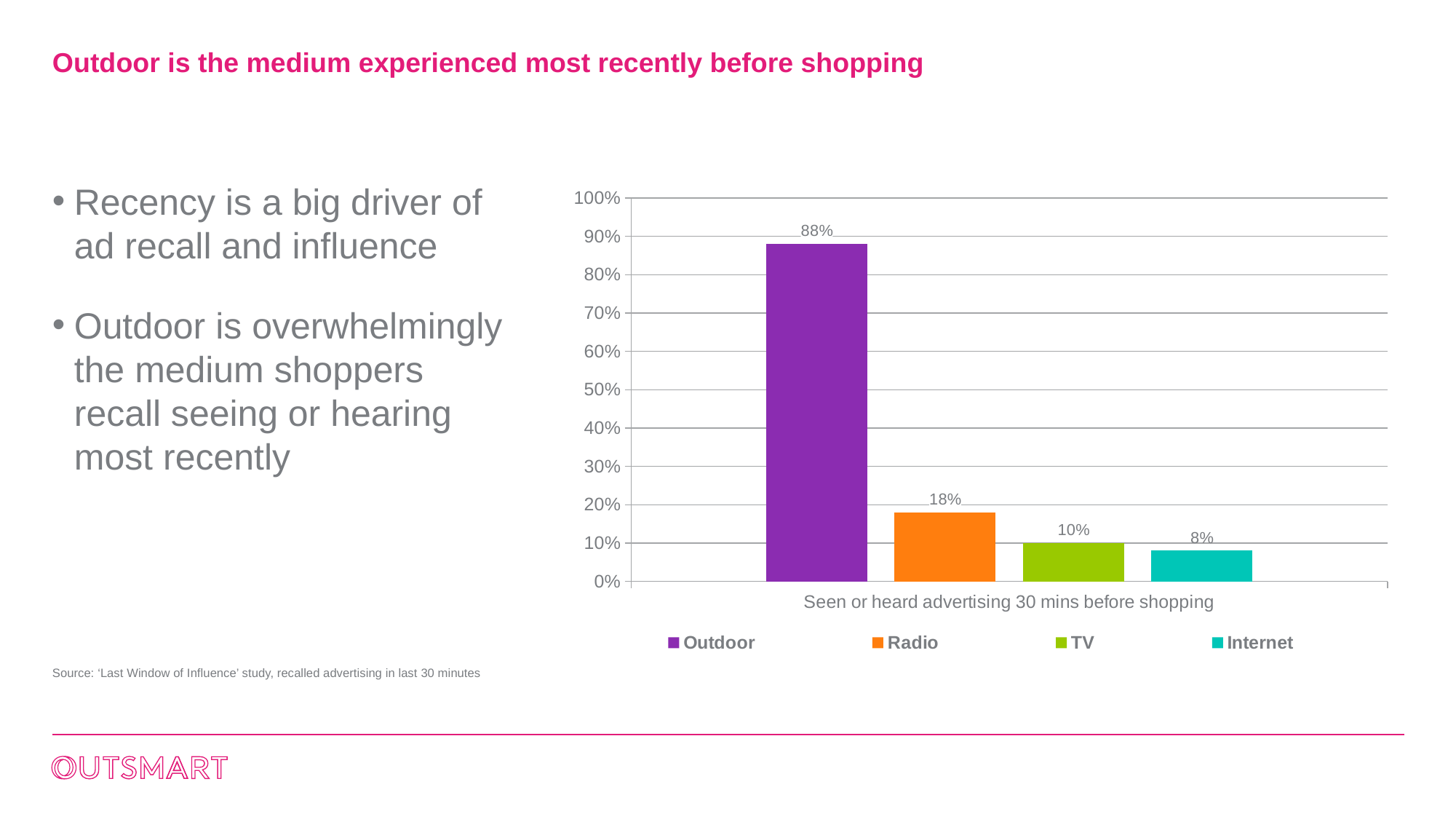
What kind of chart is shown? Bar chart How many series does the legend list? 4 Which medium has the highest value? Outdoor What is the difference between the values for TV and Internet? 2% Which medium has the lowest value? Internet What is the value for TV? 10% Which is larger, the value for Radio or the value for TV? Radio What is the value for Radio? 18% What is the difference between the values for Outdoor and Radio? 70% What is the value for Outdoor? 88% What is the x-axis category label of the chart? Seen or heard advertising 30 mins before shopping What is the value for Internet? 8%